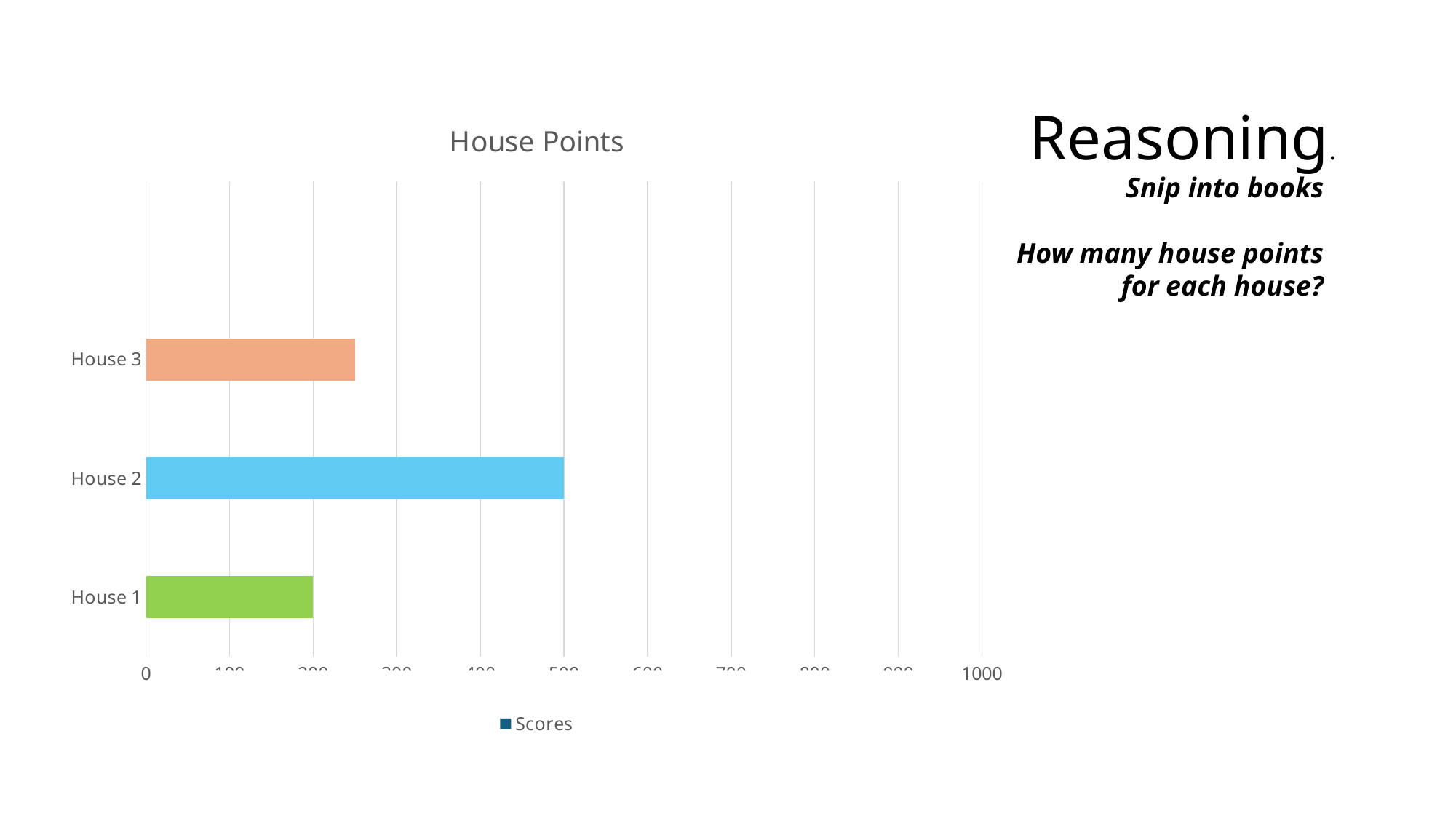
Which is larger, the value for House 2 or House 3? House 2 What is the value for House 2? 500 How many houses are shown in the chart? 3 Which house has the lowest value? House 1 How many series does the legend list? 1 What is the value for House 1? 200 Which house has the highest value? House 2 What is the difference between the values for House 2 and House 1? 300 Is the value for House 3 greater or less than 200? greater Is the value for House 3 greater or less than 300? less Which is larger, the value for House 3 or House 1? House 3 What kind of chart is shown on the slide? bar chart